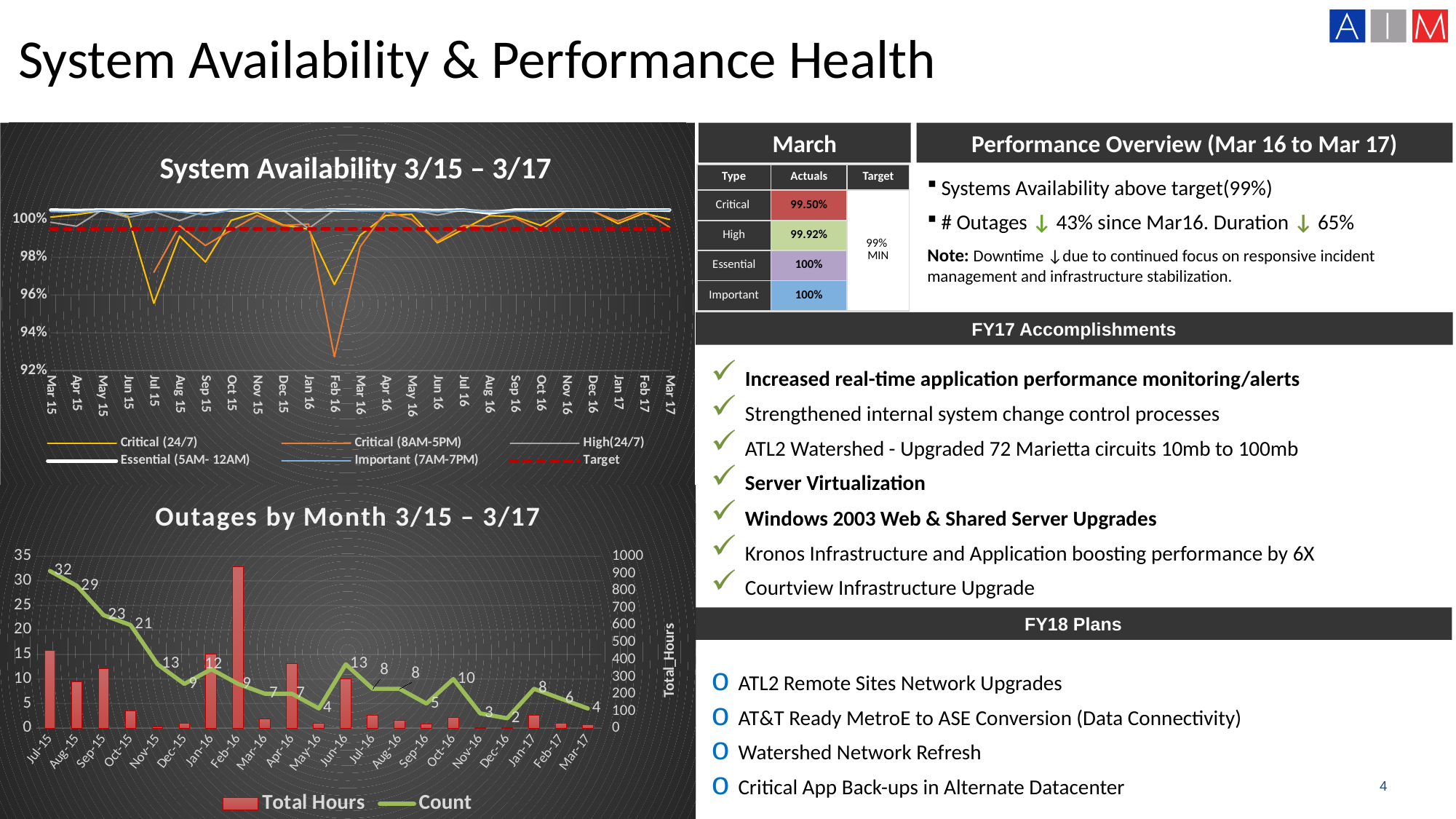
In the Outages by Month chart, which month has the lowest Count? Dec-16 How many series does the legend of the System Availability chart list? 6 In the Outages by Month chart, which month has the highest Count? Jul-15 In the Outages by Month chart, is the Total Hours value for Feb-16 greater or less than 800? greater In the Outages by Month chart, what is the Count for Mar-17? 4 In the Outages by Month chart, does the Count generally rise or fall from Jul-15 to Mar-17? fall In the Outages by Month chart, which month has the larger Count, Jun-16 or Oct-16? Jun-16 In the Outages by Month chart, what is the Count for Jul-15? 32 What kind of chart is the System Availability 3/15 – 3/17 chart? line chart In the System Availability chart, is the Critical (8AM-5PM) value for Feb 16 greater or less than 94%? less In the Outages by Month chart, what is the difference between the Count for Jul-15 and the Count for Aug-15? 3 How many series does the legend of the Outages by Month chart list? 2